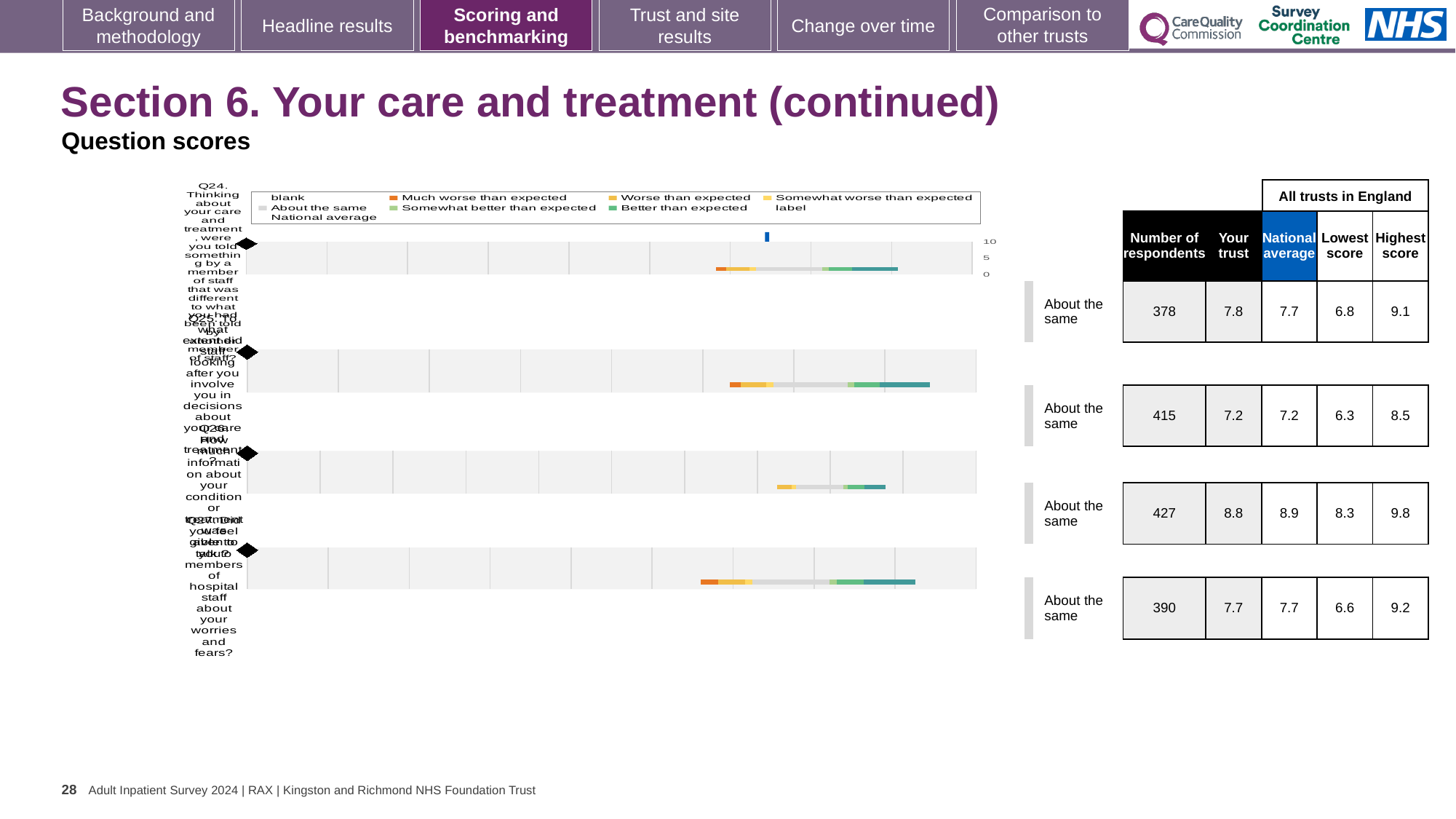
What kind of chart is used to show the benchmarking results for Q24 to Q27? bar chart What is the difference between the highest score and the lowest score shown for Q26? 1.5 Which of the four questions has the highest 'Your trust' score? Q26 What is the 'Your trust' score shown for Q24 (being told something different to what you had been told by another member of staff)? 7.8 What benchmarking category is shown next to each of the four questions? About the same What is the number of respondents shown for Q25? 415 How many questions (rows) are plotted in the chart? 4 What is the national average shown for Q26 (how much information about your condition or treatment was given to you)? 8.9 Which of the four questions has the lowest 'Your trust' score? Q25 What is the highest score across all trusts in England shown for Q27 (feeling able to talk to hospital staff about worries and fears)? 9.2 For Q24, which is larger: the 'Your trust' score or the national average? Your trust Which legend entry is shown in orange-red at the far left of the bars? Much worse than expected